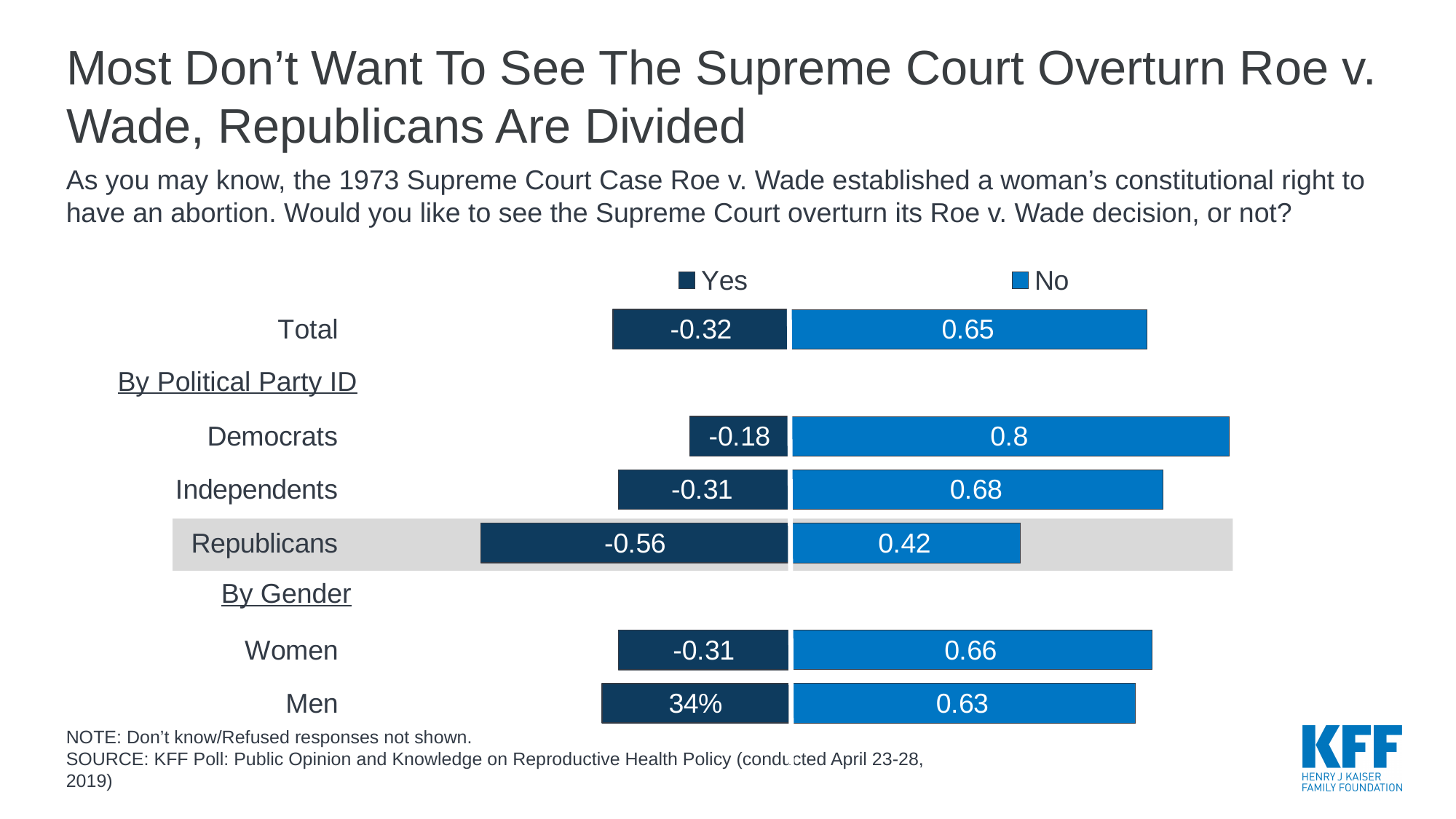
What is the data label on the Yes bar for Republicans? -0.56 What is the difference between the No values for Democrats and Republicans? 0.38 What is the data label on the No bar for Total? 0.65 What is the data label on the No bar for Democrats? 0.8 What kind of chart is shown on the slide? Bar chart Which category has the longest Yes bar? Republicans Which category has the highest No value? Democrats Which has a larger No value, Women or Men? Women How many series does the legend list? 2 How many categories are plotted in the chart? 6 Which category has the lowest No value? Republicans What is the data label on the Yes bar for Men? 34%